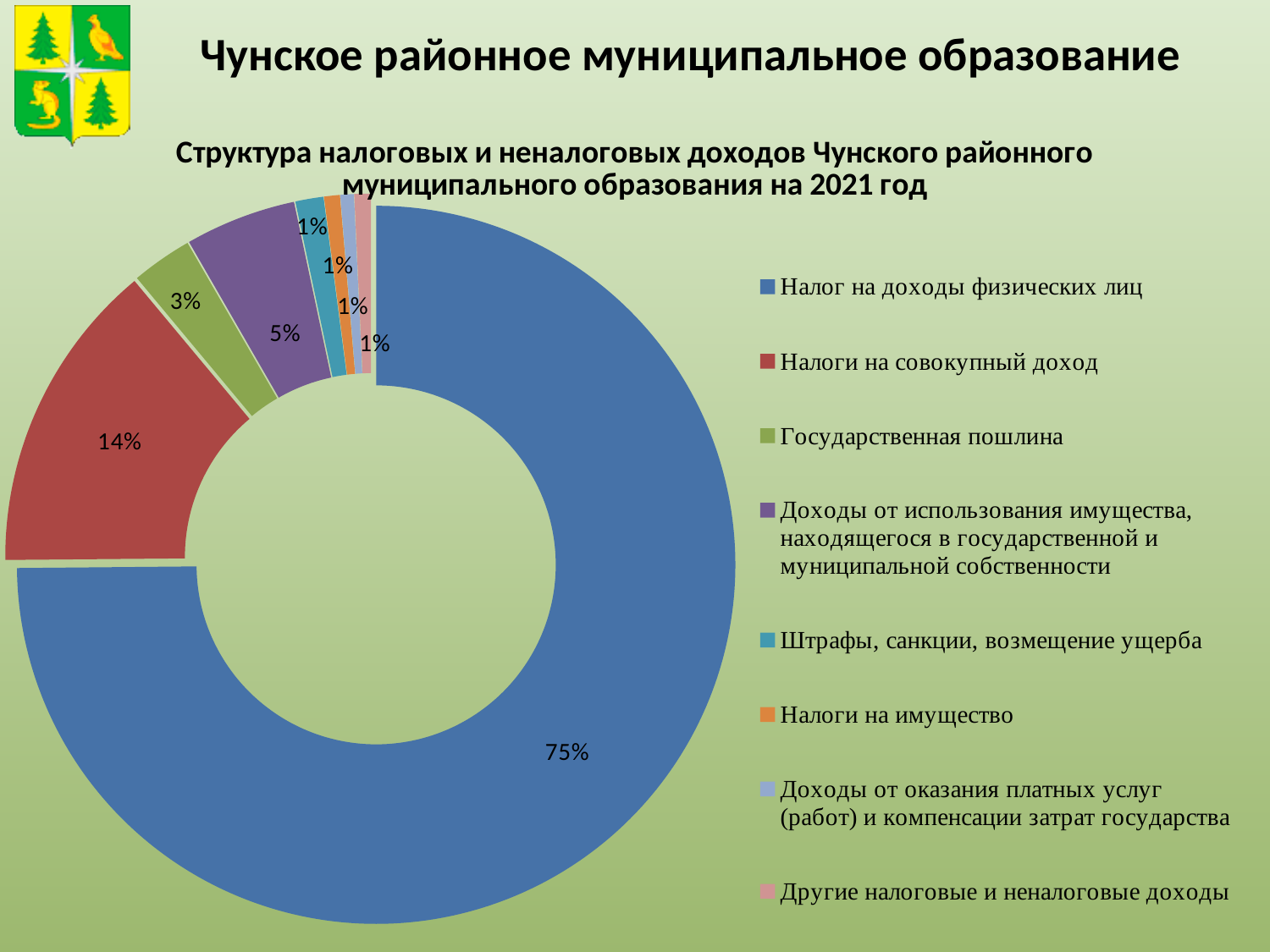
What share is shown for "Доходы от использования имущества, находящегося в государственной и муниципальной собственности"? 5% How many categories does the legend list? 8 What percentage is shown for "Штрафы, санкции, возмещение ущерба"? 1% What percentage is shown for "Налоги на совокупный доход"? 14% What is the difference in percentage points between "Налог на доходы физических лиц" and "Налоги на совокупный доход"? 61 Which is larger: the share for "Государственная пошлина" or the share for "Доходы от использования имущества, находящегося в государственной и муниципальной собственности"? Доходы от использования имущества, находящегося в государственной и муниципальной собственности What type of chart is shown on the slide? Doughnut (pie) chart What is the title of the chart? Структура налоговых и неналоговых доходов Чунского районного муниципального образования на 2021 год How many categories are labelled with 1%? 4 What percentage is shown for "Государственная пошлина"? 3% Which category has the largest share of the chart? Налог на доходы физических лиц What share of revenues does "Налог на доходы физических лиц" account for? 75%